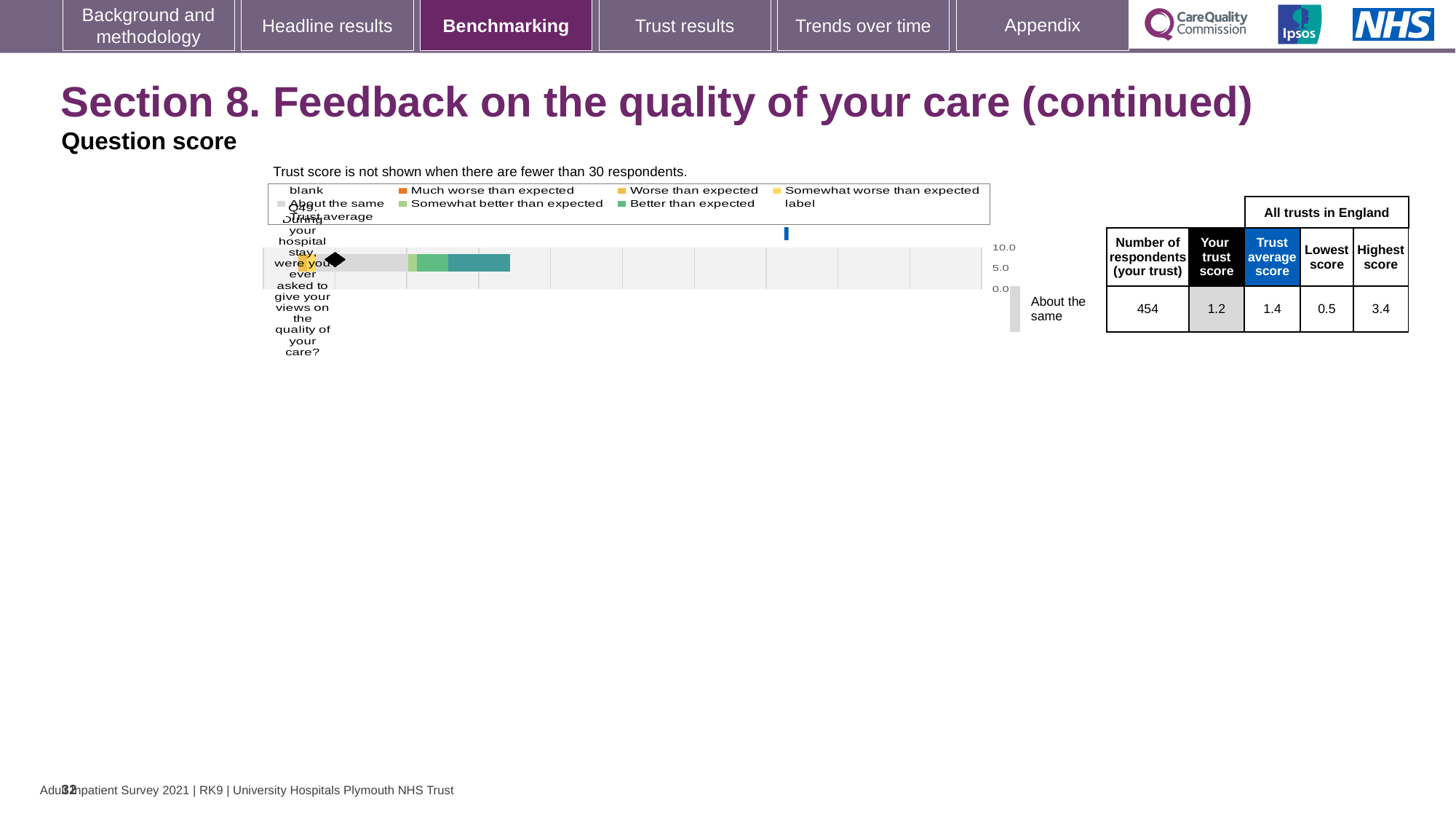
What is the lowest score across all trusts in England for Q49? 0.5 What is the difference between the highest score and the lowest score for Q49? 2.9 Which is larger for Q49, the trust score or the trust average score? Trust average score What is the trust average score for Q49? 1.4 What benchmark category is the trust's Q49 result labelled as? About the same How many survey questions are plotted on the chart? 1 What is the maximum value shown on the chart's score axis? 10.0 Is the trust score marker for Q49 plotted at a value greater or less than 5.0 on the axis? less What kind of chart is used to show the Q49 benchmarking result? bar chart What is the highest score across all trusts in England for Q49? 3.4 What is the trust score for Q49 shown in the table next to the chart? 1.2 How many respondents from the trust answered Q49? 454